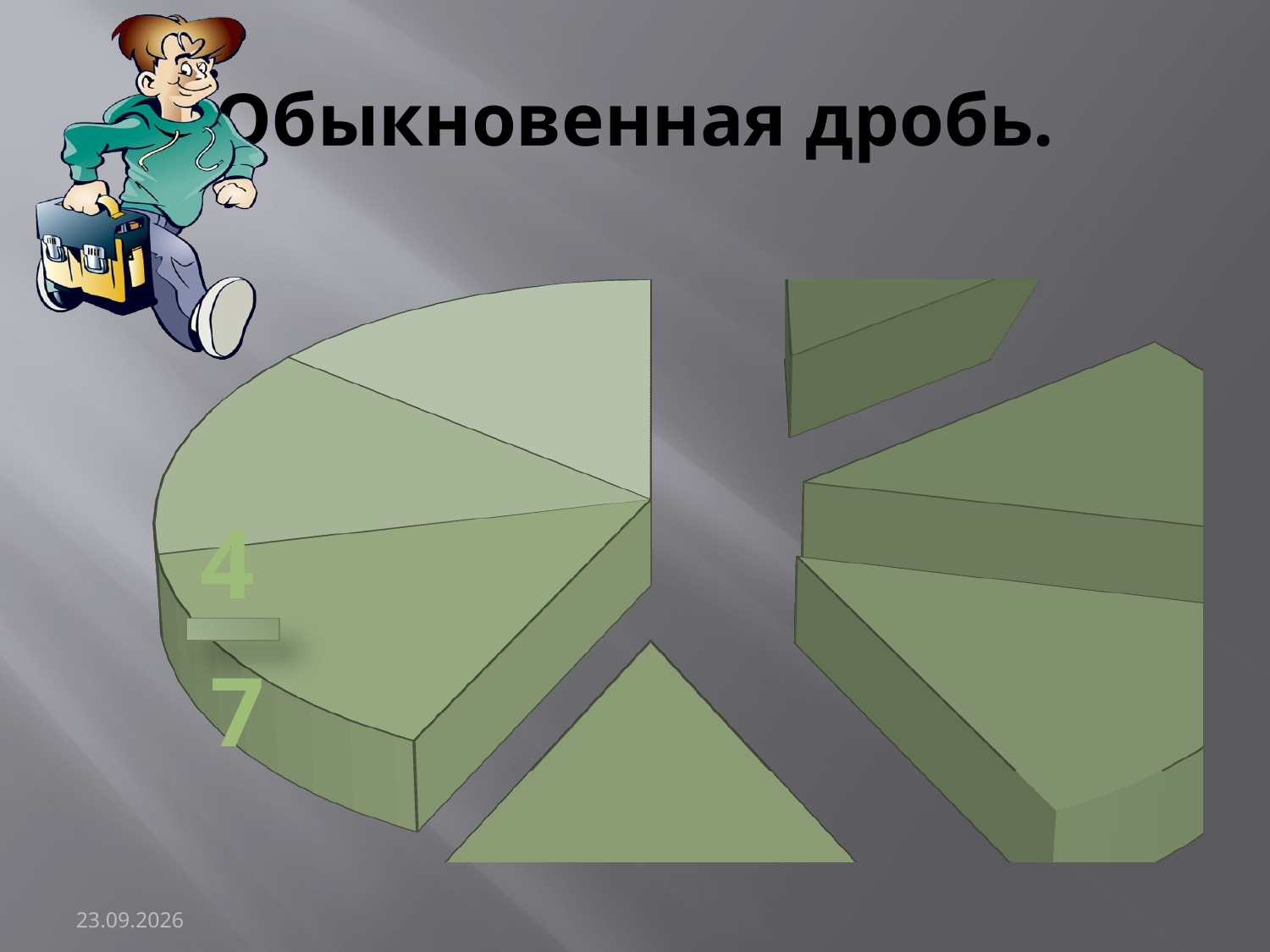
How many slices are pulled away from the large joined section of the pie? 4 How many slices does the pie chart have in total? 7 How many slices make up the joined section labelled 4/7? 3 Is the joined section labelled 4/7 larger or smaller than half of the pie? smaller What is the title of the slide above the pie chart? Обыкновенная дробь. What colour are the slices of the pie chart? green What kind of chart is shown on the slide? pie chart What label is printed on the large joined section of the pie chart? 4/7